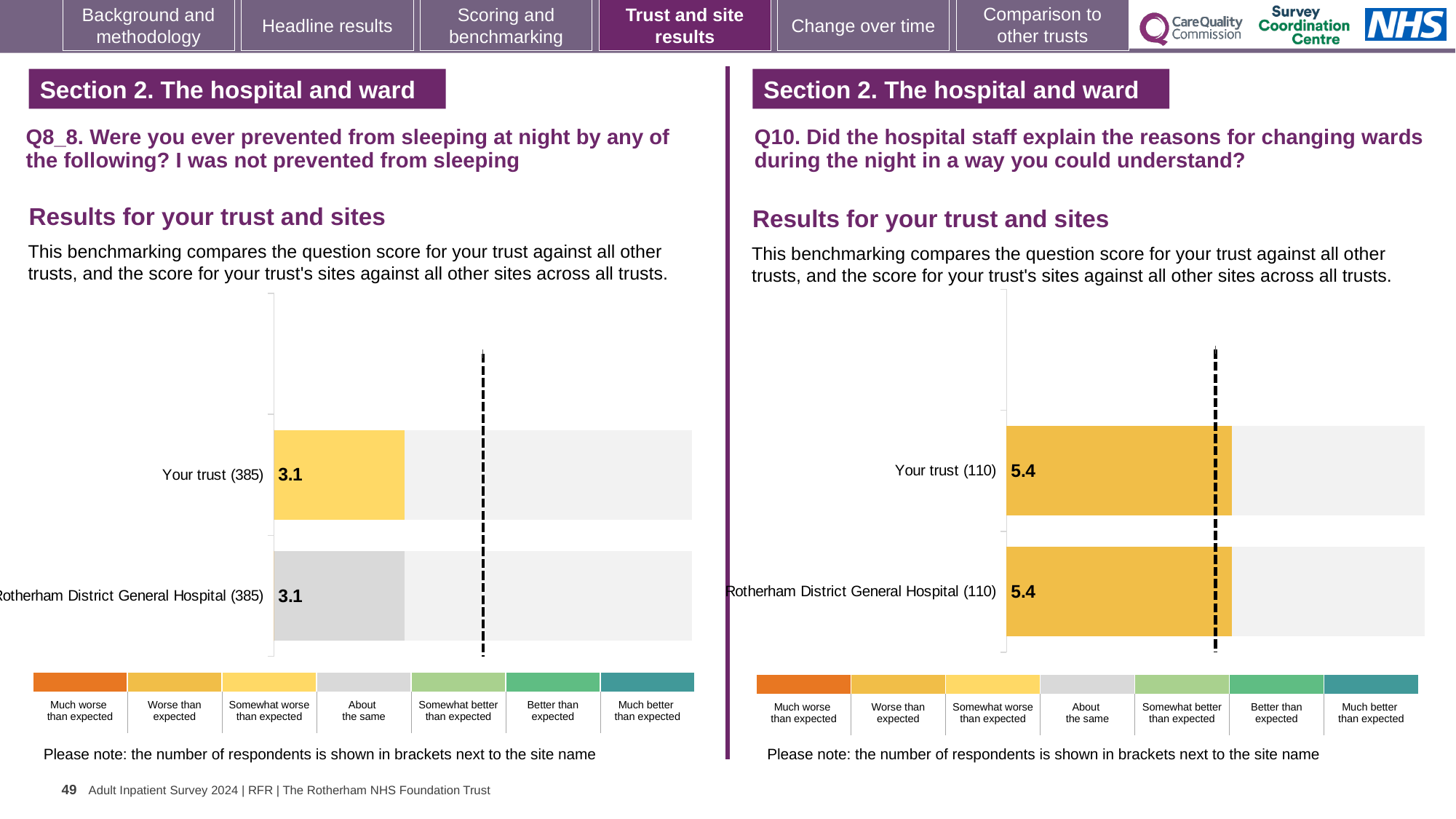
On the left chart (Q8_8), what is the score for Rotherham District General Hospital? 3.1 On the right chart (Q10), what is the difference between the score for Your trust and the score for Rotherham District General Hospital? 0 How many bars are plotted on the right chart (Q10)? 2 On the left chart (Q8_8), how many respondents are shown in brackets next to Your trust? 385 How many charts are shown on the slide? 2 On the left chart (Q8_8), what is the difference between the score for Your trust and the score for Rotherham District General Hospital? 0 On the right chart (Q10), what is the score for Your trust? 5.4 What kind of chart is the right chart (Q10)? Bar chart On the right chart (Q10), how many respondents are shown in brackets next to Rotherham District General Hospital? 110 How many bars are plotted on the left chart (Q8_8)? 2 On the right chart (Q10), what is the score for Rotherham District General Hospital? 5.4 On the left chart (Q8_8), what is the score for Your trust? 3.1